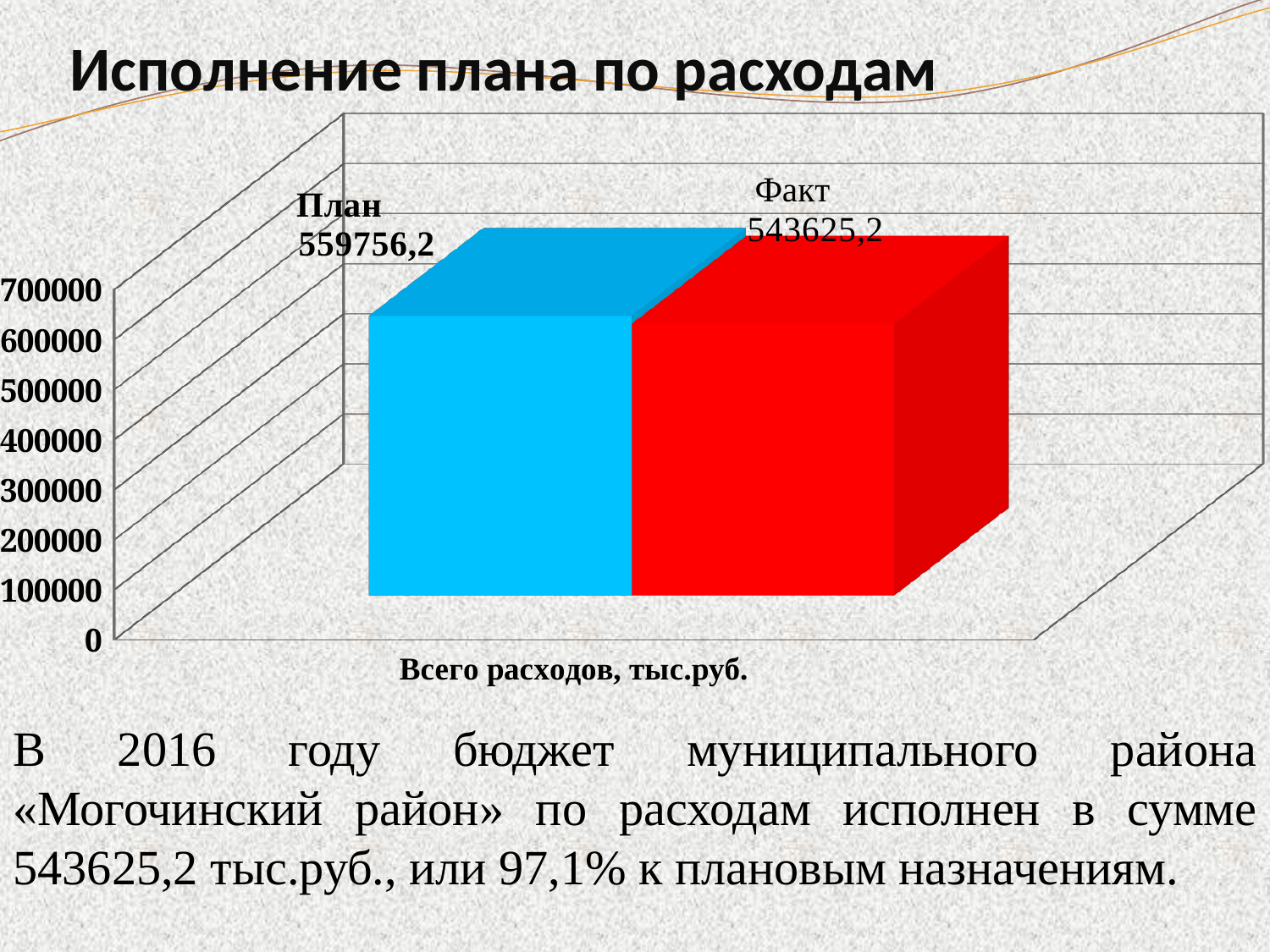
Is the value for Факт greater or less than 500000? greater What is the title of the chart on the slide? Исполнение плана по расходам What kind of chart is shown on the slide? bar chart Is the value for План greater or less than 600000? less What colour is the Факт bar? red What is the value of the План bar in the chart? 559756,2 What is the value of the Факт bar in the chart? 543625,2 What is the highest value shown on the vertical axis? 700000 Which bar has the lowest value in the chart? Факт How many bars are plotted in the chart? 2 Which bar is higher, План or Факт? План What is the difference between the План value and the Факт value? 16131